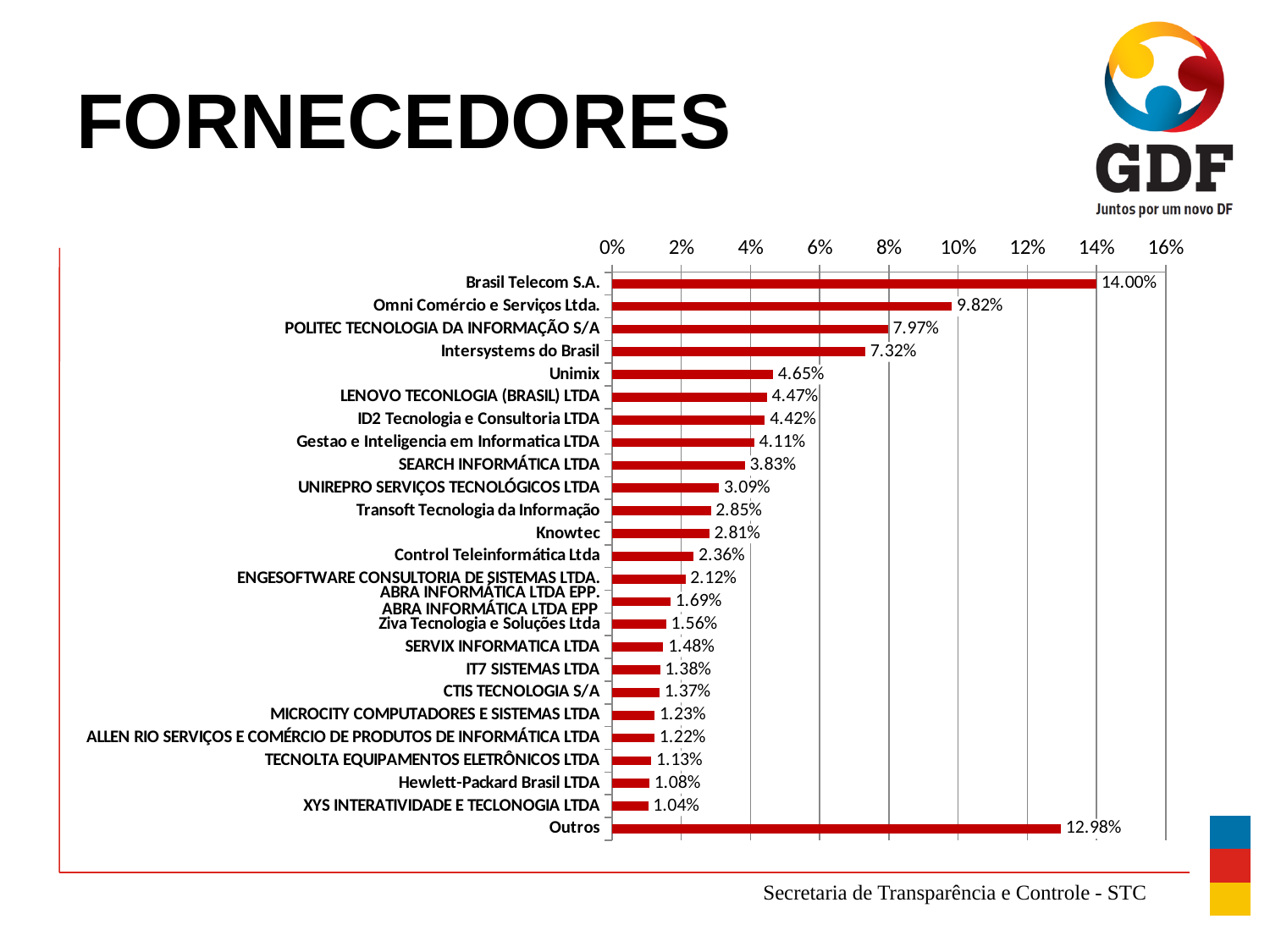
What is the title of the slide containing the chart? FORNECEDORES What is the value for Omni Comércio e Serviços Ltda.? 9.82% What is the value for Hewlett-Packard Brasil LTDA? 1.08% What is the value for Intersystems do Brasil? 7.32% What is the difference between the values for Unimix and Knowtec? 1.84% What is the value for Outros? 12.98% Which named supplier has the lowest value? XYS INTERATIVIDADE E TECLONOGIA LTDA What kind of chart is shown on the slide? Bar chart What is the value for Brasil Telecom S.A.? 14.00% Which is larger, the value for Outros or the value for Omni Comércio e Serviços Ltda.? Outros Which supplier has the highest value? Brasil Telecom S.A. What is the difference between the values for Brasil Telecom S.A. and Outros? 1.02%